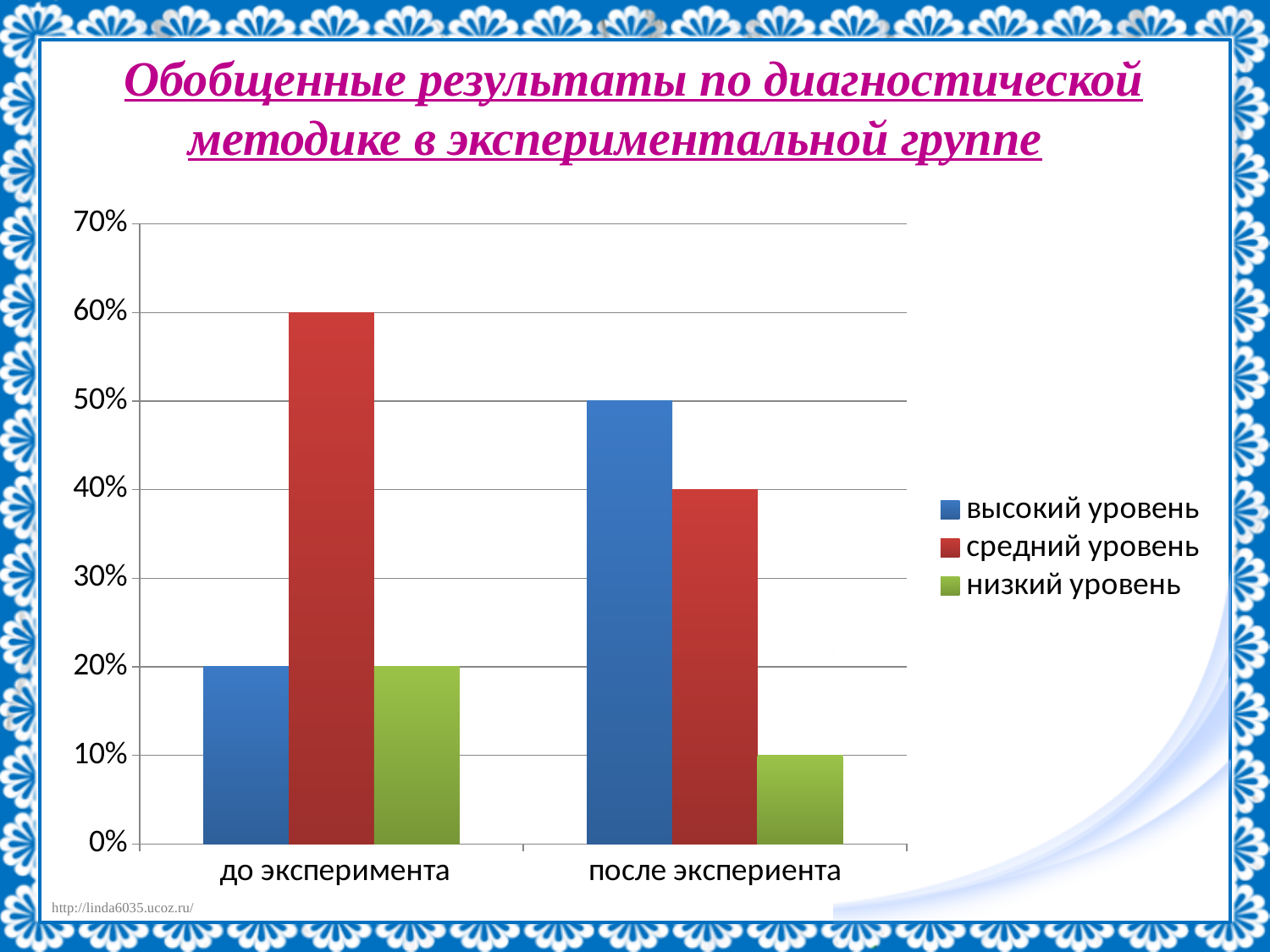
What is the value for высокий уровень in the category после экспериента? 50% What is the value for средний уровень in the category до эксперимента? 60% What is the difference between the value for высокий уровень after the experiment (после экспериента) and before the experiment (до эксперимента)? 30% What kind of chart is shown on the slide? bar chart Which is larger: средний уровень in до эксперимента or средний уровень in после экспериента? средний уровень in до эксперимента What is the value for высокий уровень in the category до эксперимента? 20% Which series has the highest value in the category до эксперимента? средний уровень How many categories are shown on the x axis? 2 What is the value for низкий уровень in the category после экспериента? 10% Which colour represents низкий уровень in the legend? green How many series does the legend list? 3 Which series has the lowest value in the category после экспериента? низкий уровень